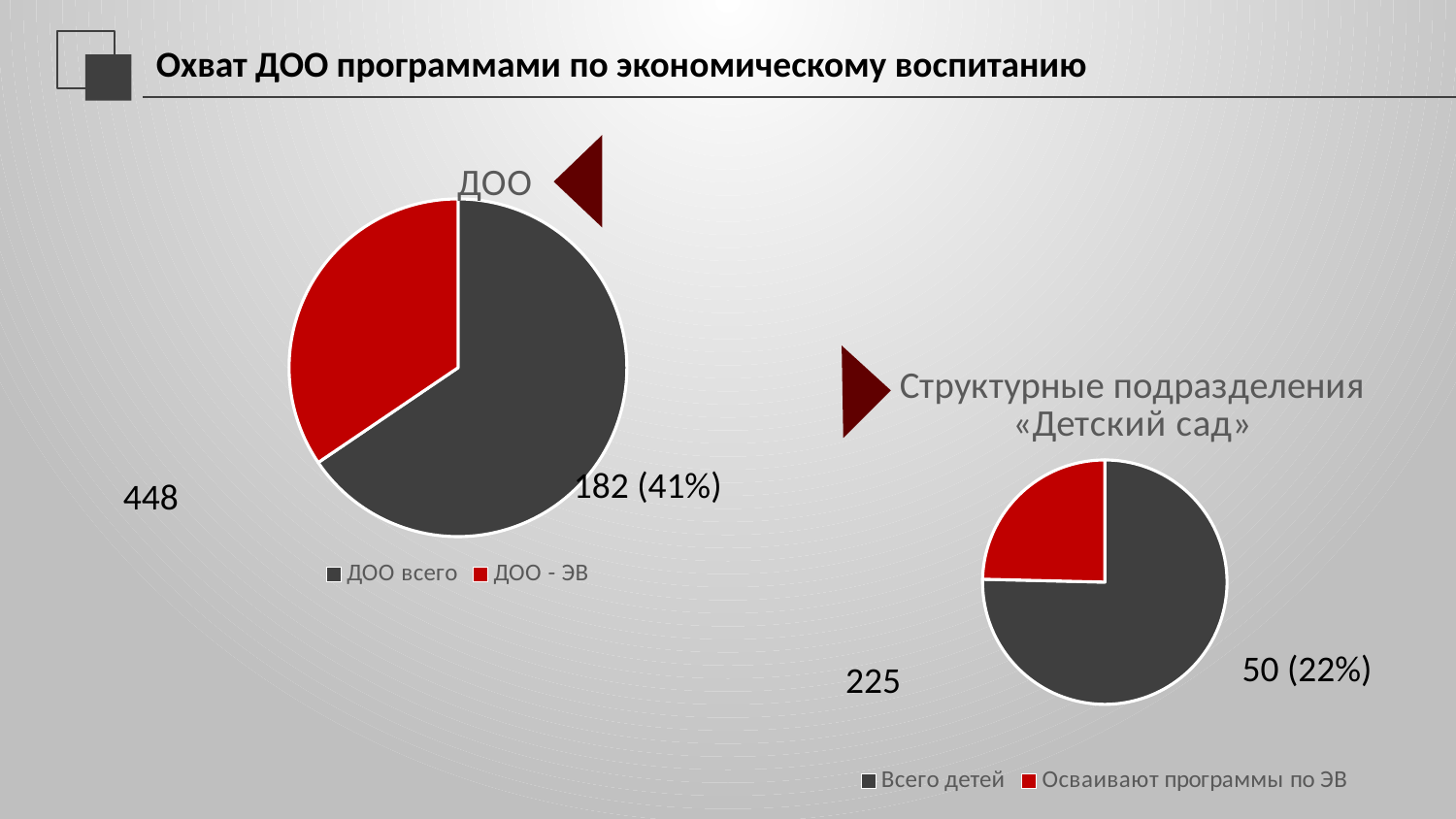
In the right chart "Структурные подразделения «Детский сад»", what percentage is printed next to the value 50? 22% In the right chart "Структурные подразделения «Детский сад»", what label is shown for "Осваивают программы по ЭВ"? 50 (22%) In the right chart "Структурные подразделения «Детский сад»", which slice is larger, "Всего детей" or "Осваивают программы по ЭВ"? Всего детей In the left chart "ДОО", what label is shown for "ДОО - ЭВ"? 182 (41%) In the left chart "ДОО", which slice is larger, "ДОО всего" or "ДОО - ЭВ"? ДОО всего In the right chart "Структурные подразделения «Детский сад»", what value is shown for "Всего детей"? 225 What kind of chart is the left chart titled "ДОО"? pie chart In the left chart "ДОО", what value is shown for "ДОО всего"? 448 In the left chart "ДОО", what is the difference between the values 448 and 182? 266 In the left chart "ДОО", what colour represents "ДОО - ЭВ" in the legend? red What kind of chart is the right chart titled "Структурные подразделения «Детский сад»"? pie chart In the left chart "ДОО", how many series does the legend list? 2